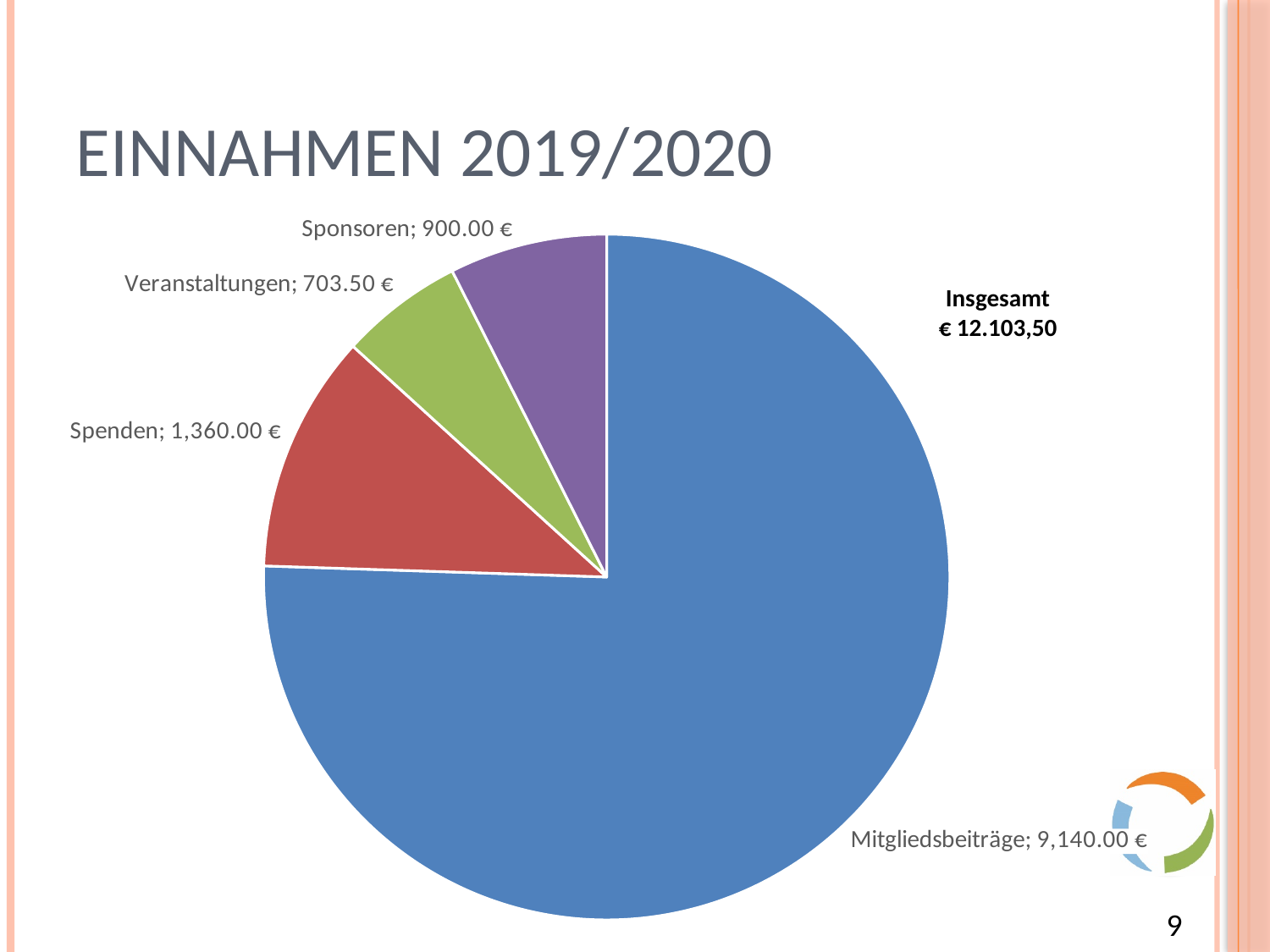
Which category has the largest slice of the pie? Mitgliedsbeiträge What kind of chart is shown on the slide? Pie chart What is the value for Mitgliedsbeiträge? 9,140.00 € What is the value for Spenden? 1,360.00 € Which is larger, Sponsoren or Veranstaltungen? Sponsoren What is the difference between Mitgliedsbeiträge and Spenden? 7,780.00 € How many slices does the pie chart have? 4 What is the title of the slide? EINNAHMEN 2019/2020 What total (Insgesamt) is printed on the chart? € 12.103,50 What is the value for Veranstaltungen? 703.50 € Which category has the smallest slice of the pie? Veranstaltungen What is the value for Sponsoren? 900.00 €